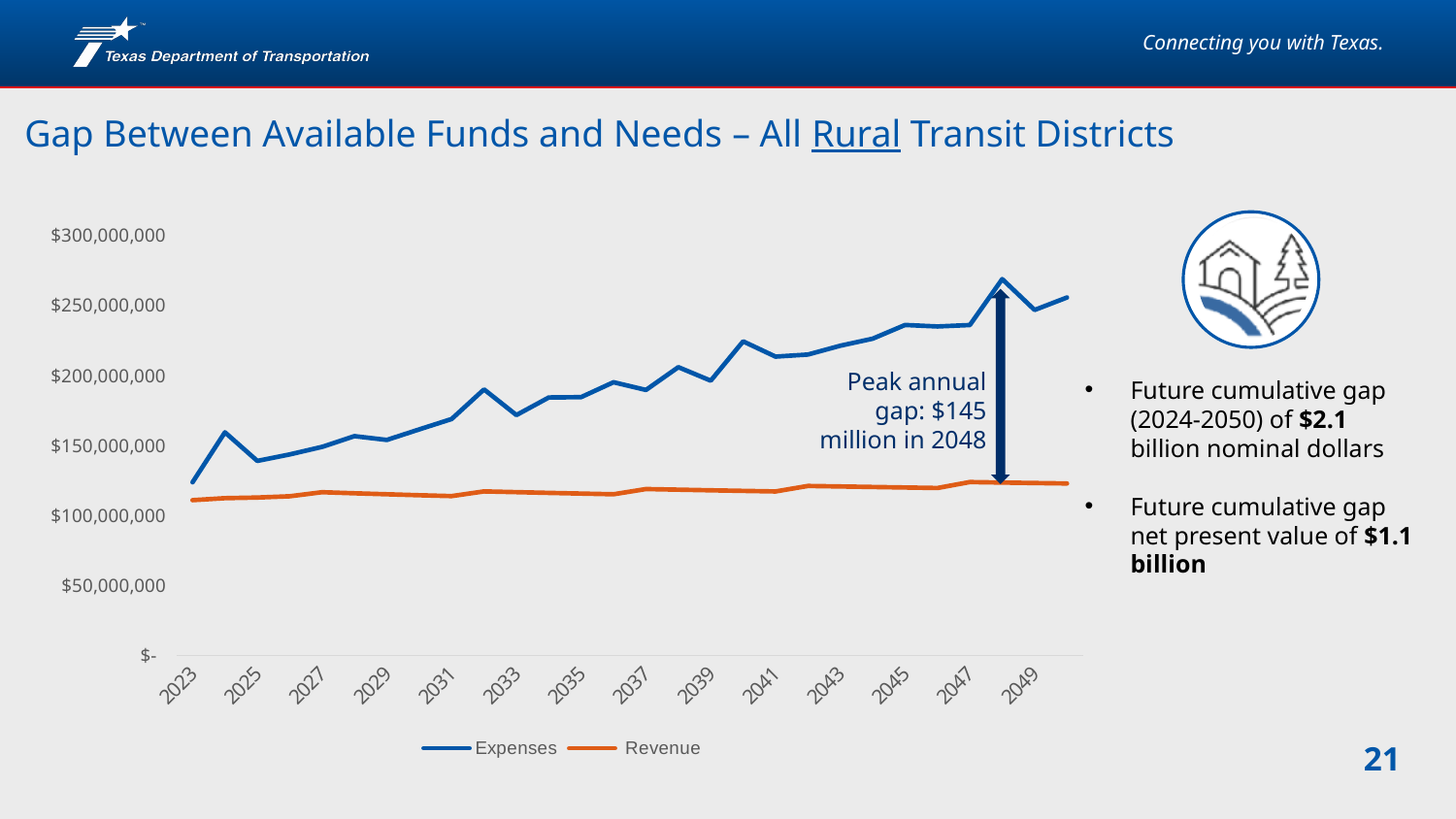
According to the annotation on the chart, what is the peak annual gap and in which year does it occur? $145 million in 2048 Is the value for Revenue in 2023 greater or less than $150,000,000? less Is the value for Expenses in 2048 greater or less than $250,000,000? greater What are the two series named in the chart legend? Expenses and Revenue Is the value for Revenue in 2049 greater or less than $150,000,000? less In which year does the Expenses line reach its highest value? 2048 What type of chart is shown on the slide? Line chart Which series has the larger value in 2041, Expenses or Revenue? Expenses How many series does the chart legend list? 2 How many year labels are shown on the x axis? 14 Does the Expenses line generally rise or fall from 2023 to 2050? Rise